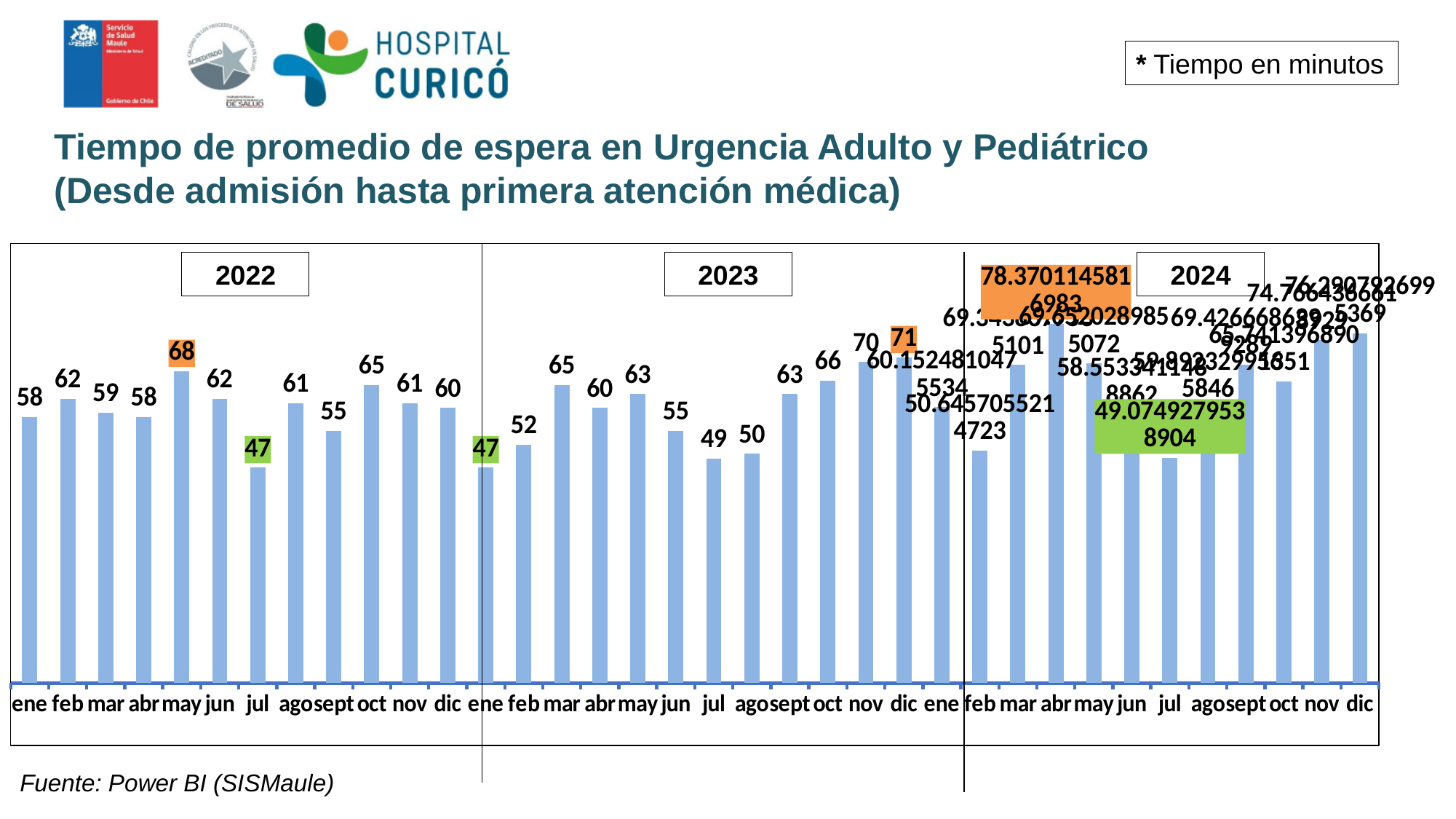
What is the value shown for December (dic) 2023? 71 Which month in 2022 has the highest value? may Which is larger: the value for October (oct) 2022 or October (oct) 2023? oct 2023 What is the value shown for September (sept) 2022? 55 Which month in 2023 has the lowest value? ene What kind of chart is shown on the slide? bar chart What is the average waiting time shown for May (may) 2022? 68 Which month in 2023 has the highest value? dic From July (jul) to December (dic) 2023, do the values rise or fall? rise Which month in 2022 has the lowest value? jul What is the difference between the December (dic) 2023 value and the January (ene) 2023 value? 24 In what unit are the values on the chart expressed, according to the note on the slide? minutos